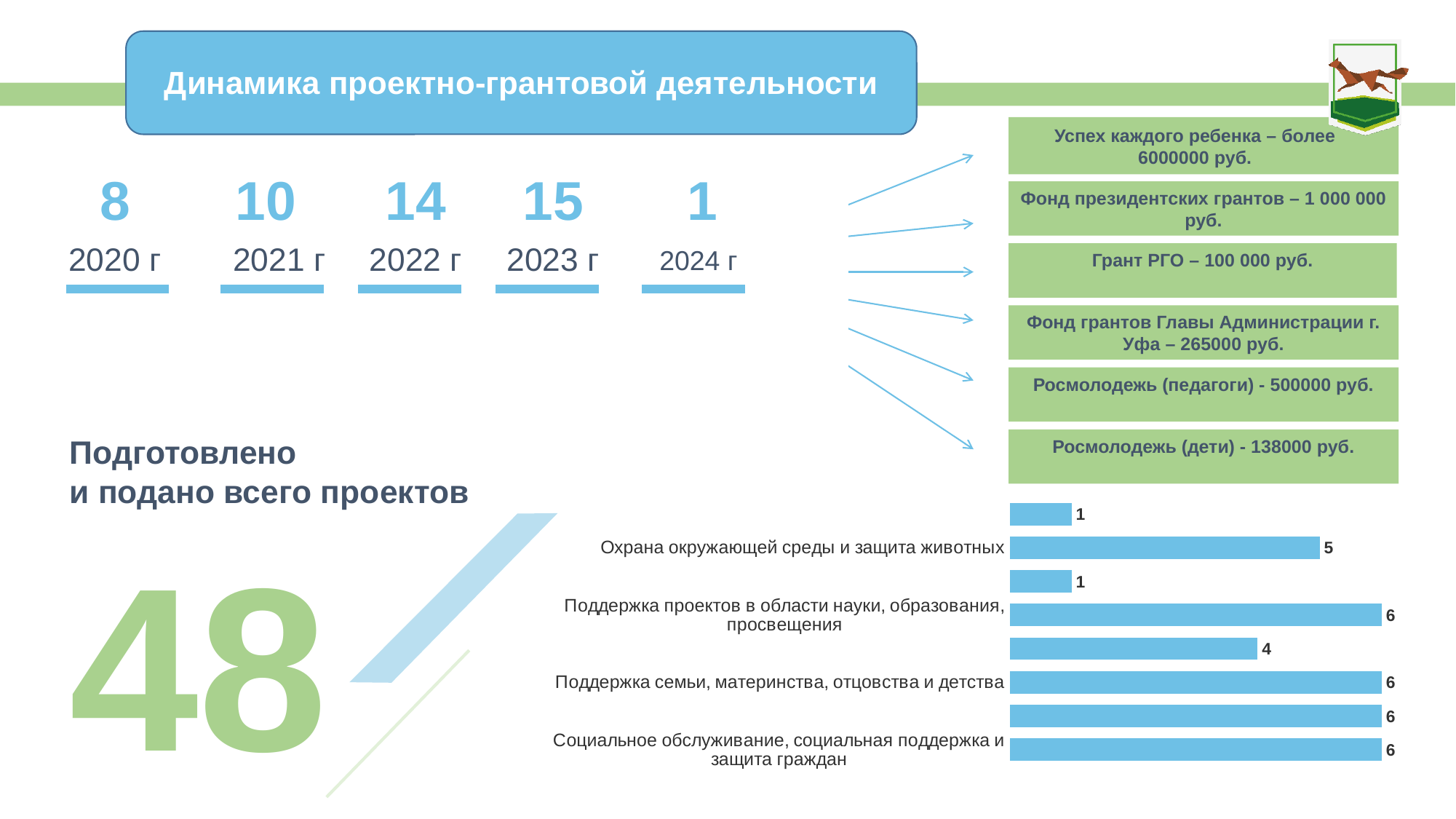
In the bar chart, what is the value for "Охрана окружающей среды и защита животных"? 5 What is the smallest data label value shown on any bar in the bar chart? 1 In the bar chart, which is larger: the value for "Охрана окружающей среды и защита животных" or the value for "Поддержка семьи, материнства, отцовства и детства"? Поддержка семьи, материнства, отцовства и детства What kind of chart is shown at the bottom right of the slide? bar chart How many bars does the bar chart at the bottom right of the slide contain? 8 What is the largest data label value shown on any bar in the bar chart? 6 What colour are the bars in the bar chart? blue In the bar chart, what is the value for "Поддержка семьи, материнства, отцовства и детства"? 6 In the bar chart, what is the difference between the value for "Поддержка проектов в области науки, образования, просвещения" and the value for "Охрана окружающей среды и защита животных"? 1 In the bar chart, what is the value for "Социальное обслуживание, социальная поддержка и защита граждан"? 6 In the bar chart, is the value for "Охрана окружающей среды и защита животных" greater or less than the value for "Социальное обслуживание, социальная поддержка и защита граждан"? less In the bar chart, what is the value for "Поддержка проектов в области науки, образования, просвещения"? 6